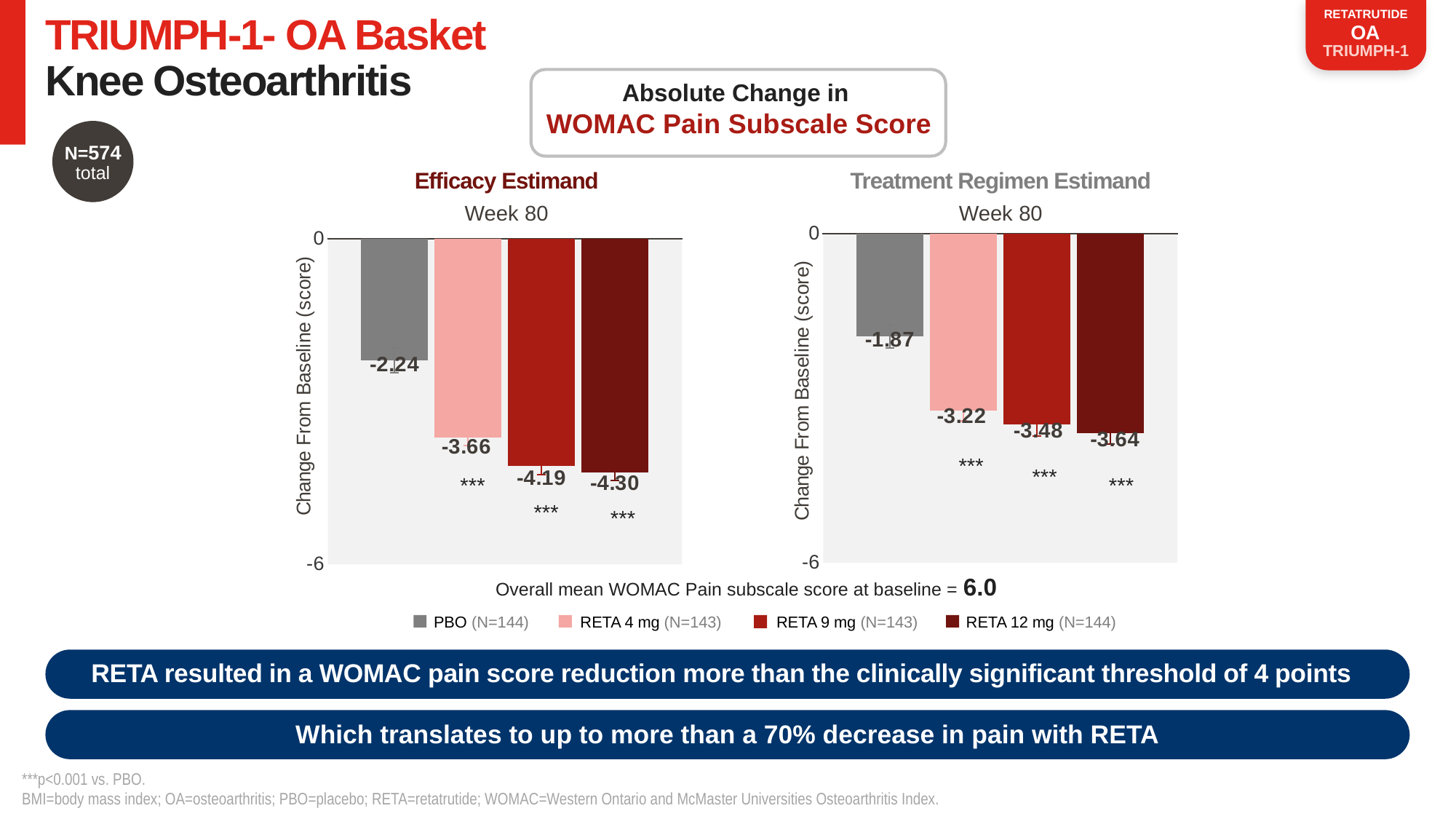
In the Efficacy Estimand chart, what is the change from baseline for RETA 12 mg? -4.30 How many bars are shown in the Treatment Regimen Estimand chart? 4 Which chart shows a larger reduction for RETA 9 mg, the Efficacy Estimand chart or the Treatment Regimen Estimand chart? Efficacy Estimand In the Efficacy Estimand chart, what is the difference between the RETA 12 mg and PBO values? 2.06 How many series does the legend list? 4 In the Efficacy Estimand chart, which group shows the largest reduction from baseline? RETA 12 mg In the Treatment Regimen Estimand chart, what is the change from baseline for RETA 4 mg? -3.22 In the Treatment Regimen Estimand chart, what is the change from baseline for RETA 9 mg? -3.48 What kind of chart is the Efficacy Estimand chart? Bar chart In the Treatment Regimen Estimand chart, which group shows the smallest reduction from baseline? PBO In the Efficacy Estimand chart, what is the change from baseline for PBO? -2.24 In the Treatment Regimen Estimand chart, what is the difference between the RETA 4 mg and PBO values? 1.35